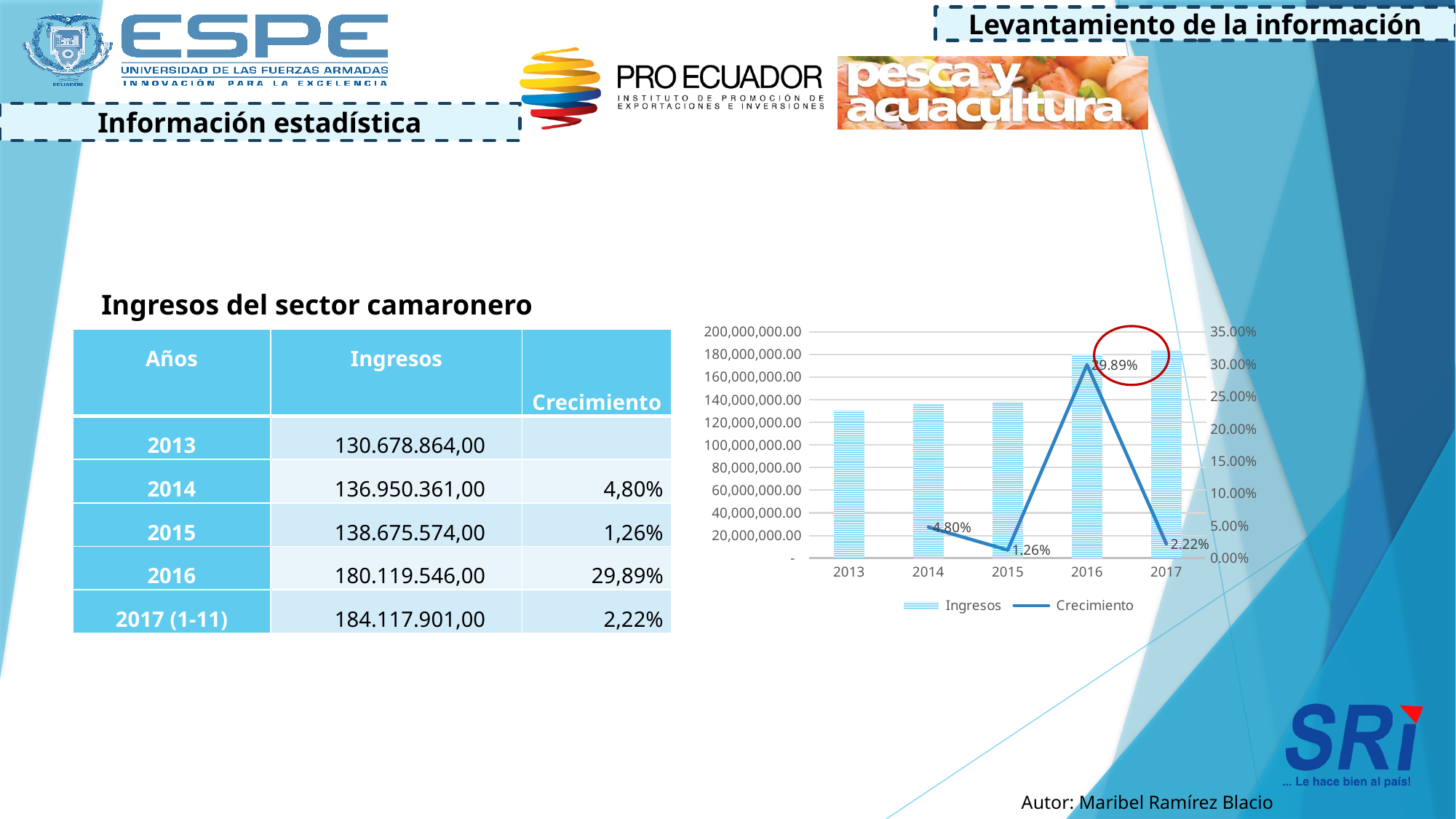
Which year has the lowest Ingresos bar on the chart? 2013 How many years are shown on the x axis of the chart? 5 What is the Crecimiento value shown for 2016 on the chart? 29.89% How many series does the chart legend list? 2 What is the Crecimiento value shown for 2015 on the chart? 1.26% Is the Ingresos bar for 2016 greater or less than 160,000,000.00? greater Which year has the highest Crecimiento value on the chart? 2016 Which is larger, the Crecimiento value for 2014 or for 2017? 2014 What is the Crecimiento value shown for 2014 on the chart? 4.80% Is the Ingresos bar for 2013 greater or less than 140,000,000.00? less Which year has the lowest Crecimiento value on the chart? 2015 What is the difference between the Crecimiento values for 2016 and 2014? 25.09%